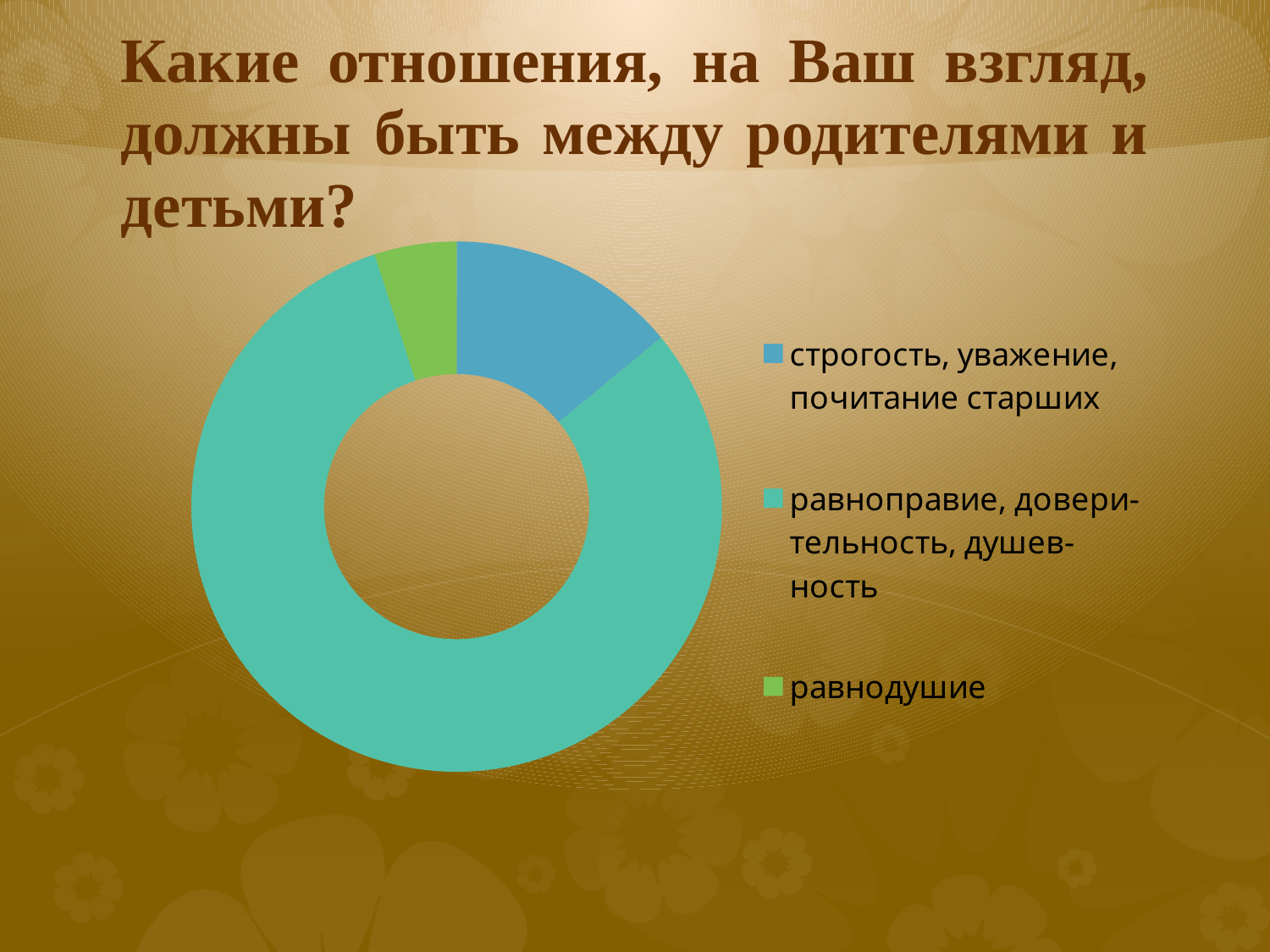
What kind of chart is shown on the slide? doughnut chart What colour represents "равнодушие" in the chart? green What is the title of the chart on the slide? Какие отношения, на Ваш взгляд, должны быть между родителями и детьми? How many categories (slices) does the chart have? 3 Which is larger: the share for "равноправие, доверительность, душевность" or the share for "строгость, уважение, почитание старших"? равноправие, доверительность, душевность Which category has the largest share of the chart? равноправие, доверительность, душевность Is the share for "равноправие, доверительность, душевность" greater or less than half of the chart? greater Which category has the smallest share of the chart? равнодушие Which is larger: the share for "строгость, уважение, почитание старших" or the share for "равнодушие"? строгость, уважение, почитание старших How many entries does the legend list? 3